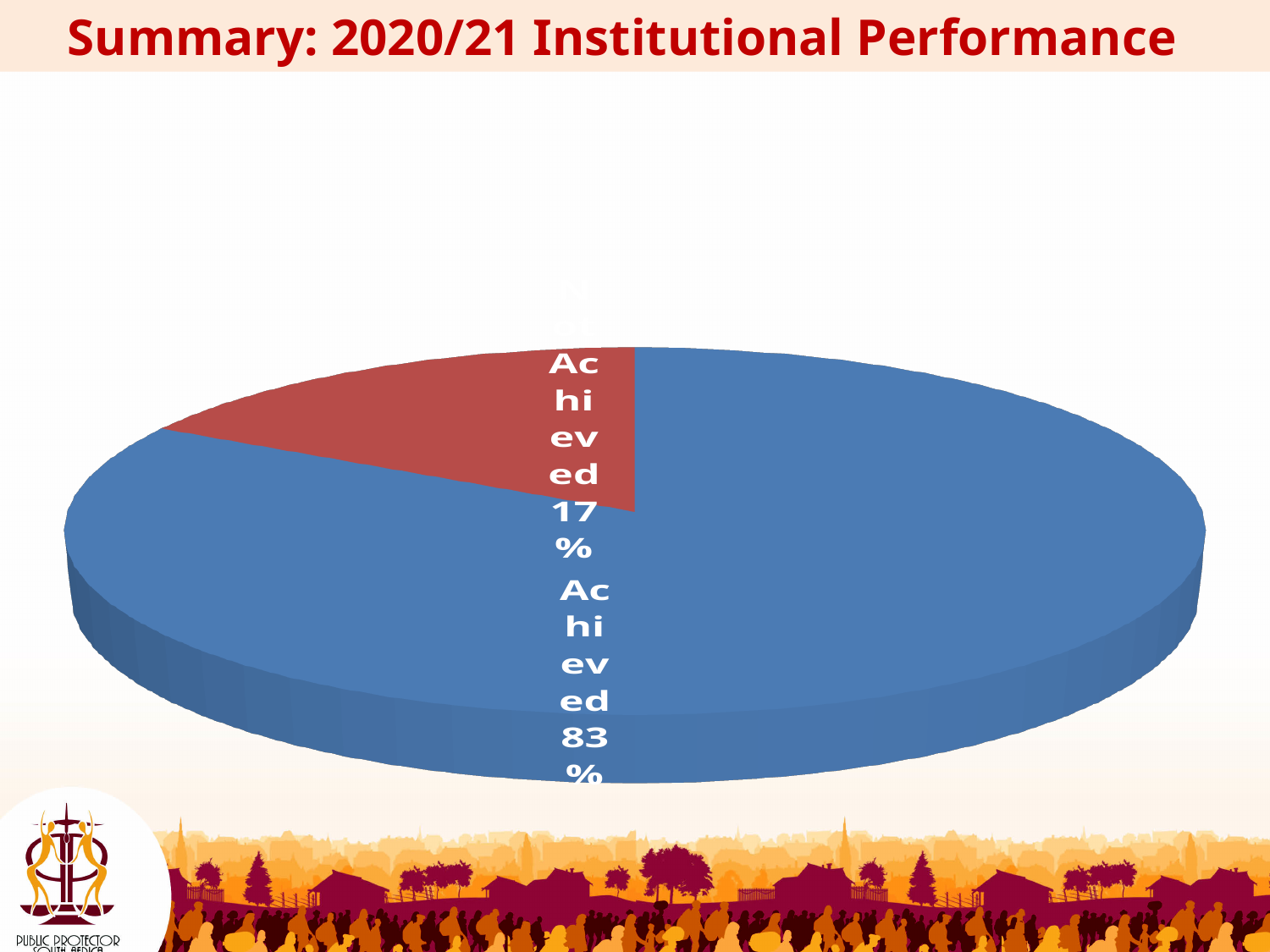
What is the difference in percentage points between the blue slice and the red slice? 66 What percentage is shown for the red slice of the pie chart? 17% Which slice of the pie chart is the smallest? the red slice (17%) Which slice of the pie chart is the largest? the blue slice (83%) How many slices does the pie chart have? 2 What share of the pie does the blue slice represent? 83% What percentage is labelled 'Achieved' on the large blue slice? 83% What percentage is shown for the blue slice of the pie chart? 83% What is the title of the slide containing the pie chart? Summary: 2020/21 Institutional Performance What kind of chart is shown on the slide? pie chart Is the red slice's share greater or less than 50%? less Which is larger, the blue slice or the red slice? the blue slice